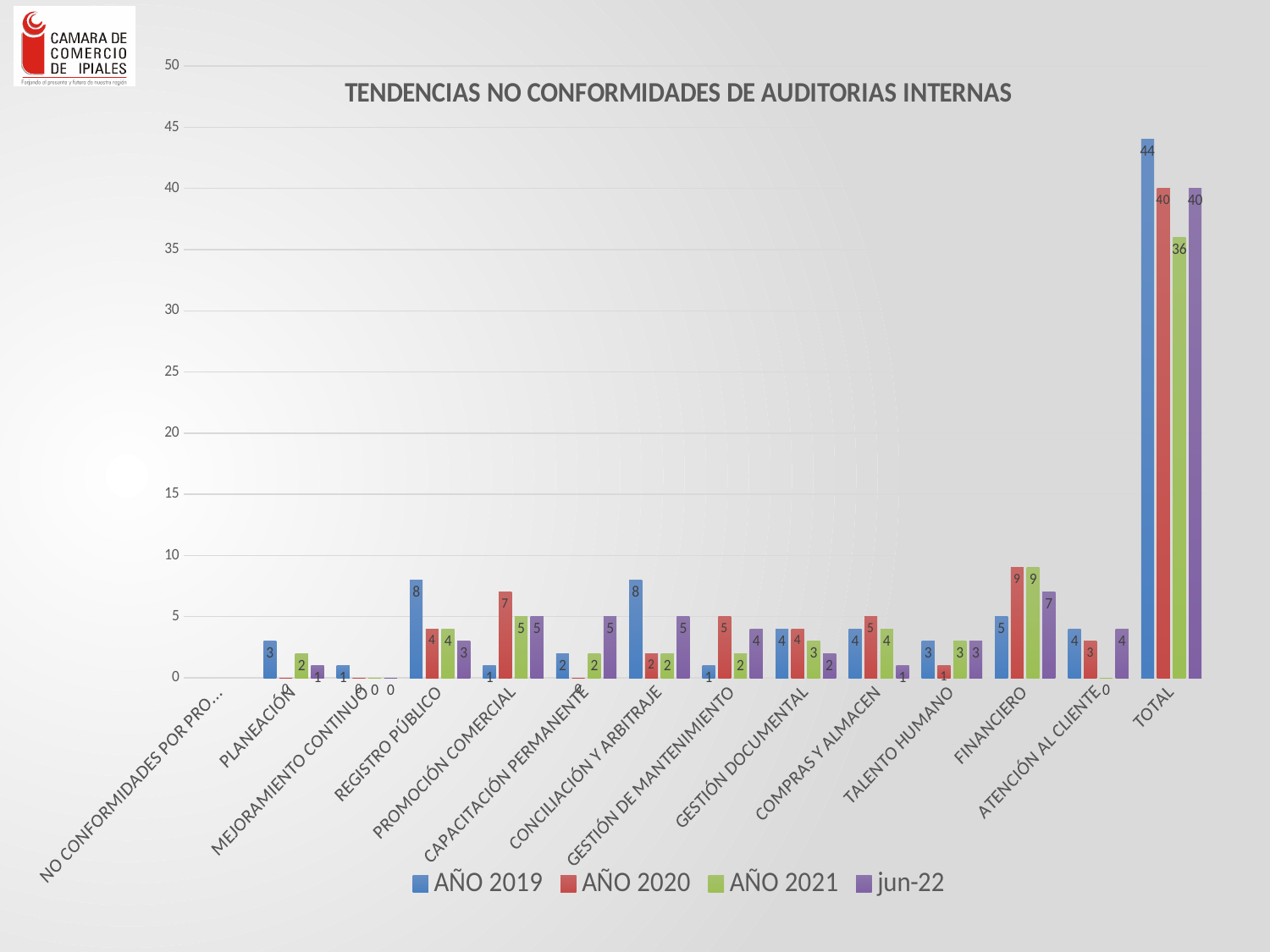
What is the value for PROMOCIÓN COMERCIAL in the jun-22 series? 5 What is the difference between the AÑO 2019 and AÑO 2021 values for TOTAL? 8 What kind of chart is shown on the slide? Bar chart How many series does the legend list? 4 What is the value for TOTAL in the AÑO 2019 series? 44 What is the title of the chart? TENDENCIAS NO CONFORMIDADES DE AUDITORIAS INTERNAS Which series has the highest value for TOTAL? AÑO 2019 How many categories are shown on the x axis? 14 What is the value for REGISTRO PÚBLICO in the AÑO 2019 series? 8 Which series has the lowest value for TOTAL? AÑO 2021 What is the value for FINANCIERO in the AÑO 2020 series? 9 Which is larger for CONCILIACIÓN Y ARBITRAJE: the AÑO 2019 value or the jun-22 value? AÑO 2019